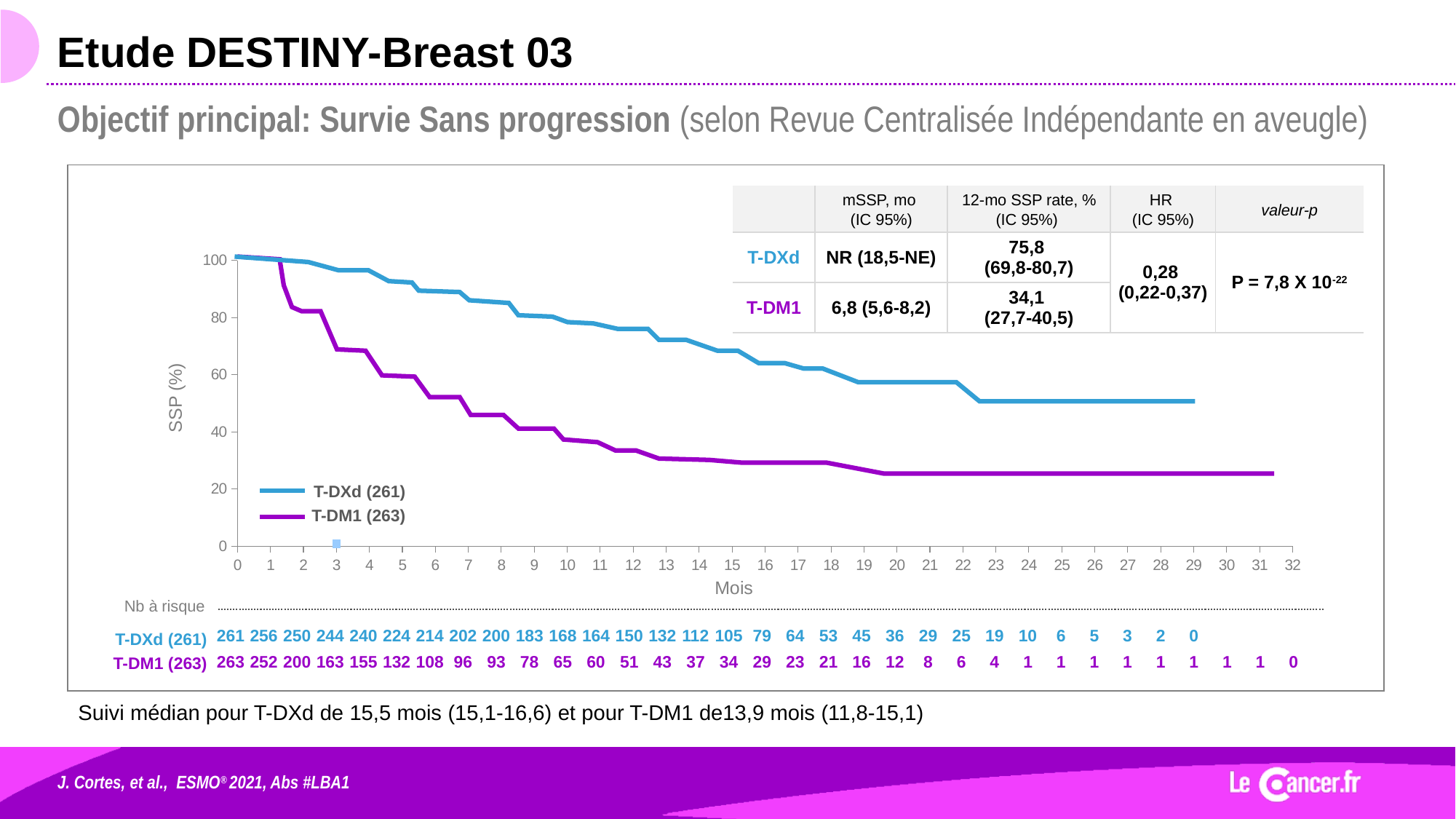
What kind of chart is shown on the slide? Line chart In the number-at-risk table, how many T-DXd patients are at risk at 12 months? 150 What are the two series named in the chart legend? T-DXd (261) and T-DM1 (263) According to the table on the chart, what is the 12-month SSP rate for T-DXd? 75,8 (69,8-80,7) Do the curves rise or fall as the months increase along the x axis? Fall What is the difference between the number at risk for T-DXd and T-DM1 at 12 months? 99 At 12 months, is the SSP (%) value for T-DM1 greater or less than 40? less At 24 months, is the SSP (%) value for T-DM1 greater or less than 40? less How many series does the chart legend list? 2 At 18 months, which curve is higher, T-DXd or T-DM1? T-DXd In the number-at-risk table, how many T-DM1 patients are at risk at 6 months? 108 At 12 months, is the SSP (%) value for T-DXd greater or less than 60? greater